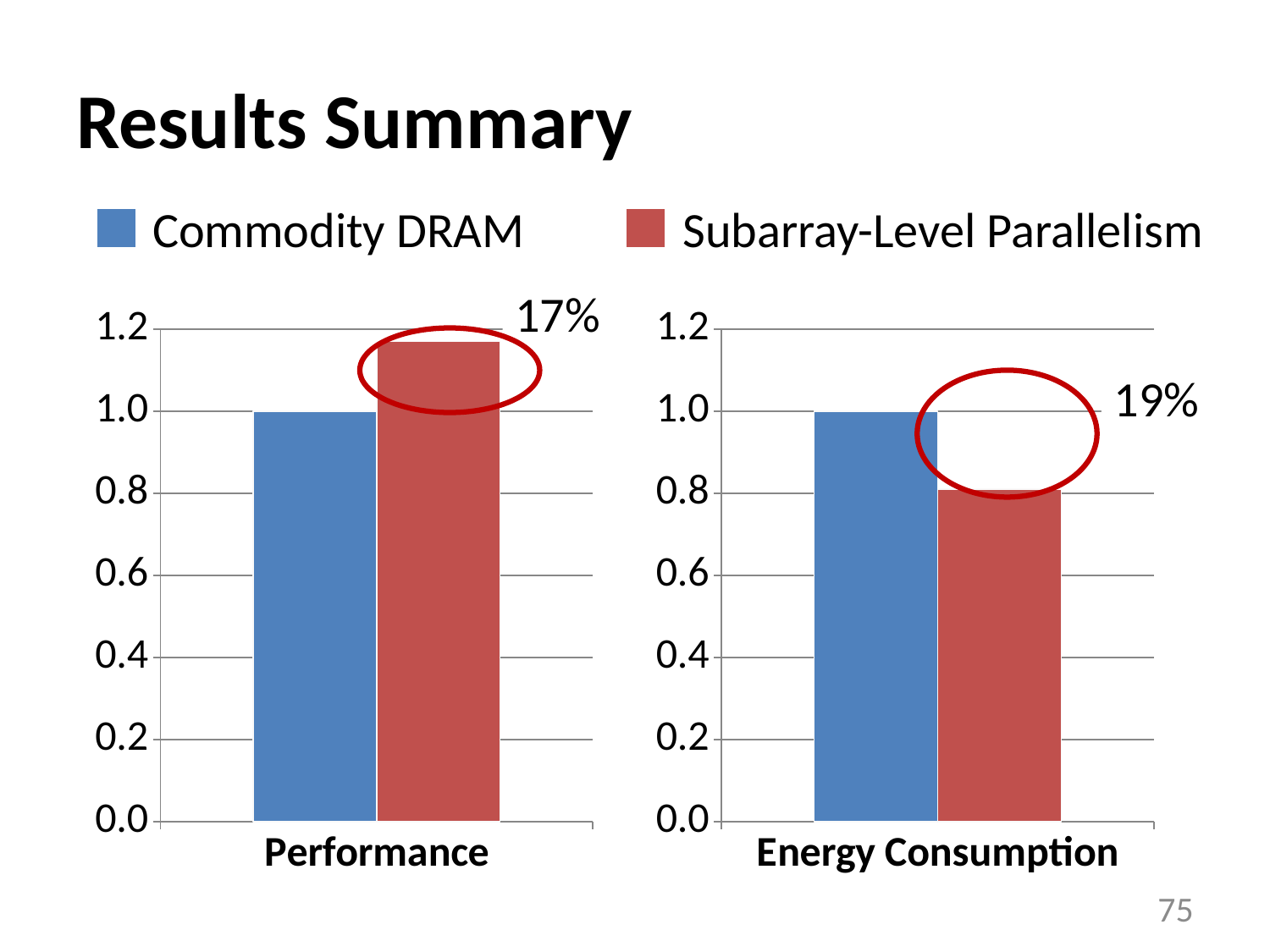
In the Energy Consumption chart, is the value for Subarray-Level Parallelism greater or less than 1.0? less In the Energy Consumption chart, what is the value for Commodity DRAM? 1.0 What percentage is annotated next to the circled bar in the Energy Consumption chart? 19% In the Energy Consumption chart, is the value for Subarray-Level Parallelism greater or less than 0.6? greater In the Energy Consumption chart, which is larger: Commodity DRAM or Subarray-Level Parallelism? Commodity DRAM How many series does the legend list? 2 In the Performance chart, what is the value for Commodity DRAM? 1.0 In the Energy Consumption chart, which series has the lower bar? Subarray-Level Parallelism In the Performance chart, which series has the higher bar? Subarray-Level Parallelism In the Performance chart, is the value for Subarray-Level Parallelism greater or less than 1.0? greater What kind of chart is the Performance chart? bar chart